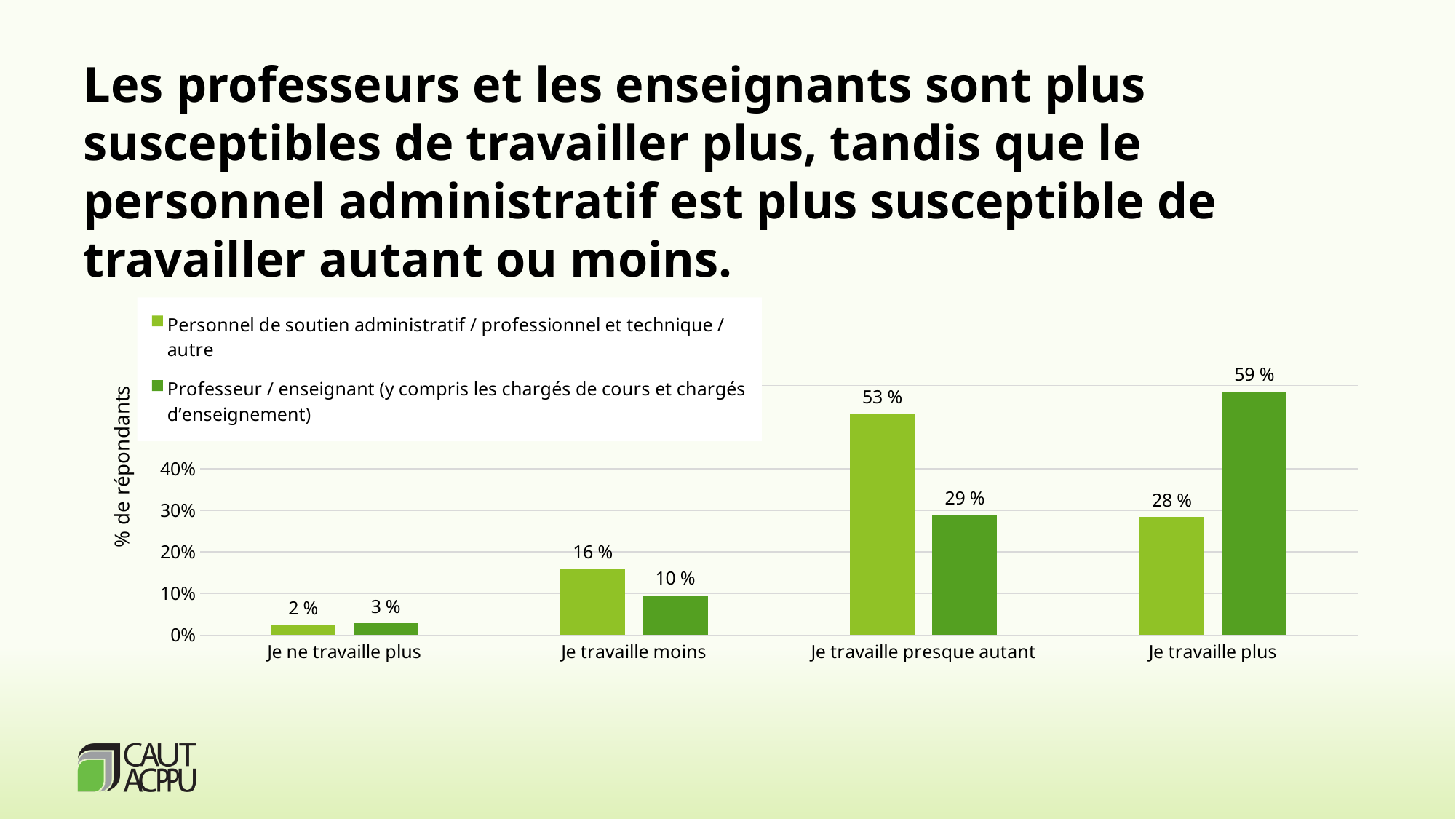
Is the value for 'Je travaille plus' for the 'Personnel de soutien administratif / professionnel et technique / autre' series greater or less than 30%? less What is the value for 'Je travaille plus' for the 'Professeur / enseignant' series? 59 % Which category has the highest value for the 'Professeur / enseignant' series? Je travaille plus What kind of chart is shown on the slide? Bar chart What is the value for 'Je travaille moins' for the 'Professeur / enseignant' series? 10 % What is the difference between the two series for 'Je travaille presque autant'? 24 % What is the difference between the two series for 'Je travaille plus'? 31 % How many categories are shown on the x axis? 4 For 'Je travaille moins', which series has the larger value? Personnel de soutien administratif / professionnel et technique / autre What is the value for 'Je travaille presque autant' for the 'Personnel de soutien administratif / professionnel et technique / autre' series? 53 % How many series does the legend list? 2 Which category has the lowest value for the 'Personnel de soutien administratif / professionnel et technique / autre' series? Je ne travaille plus